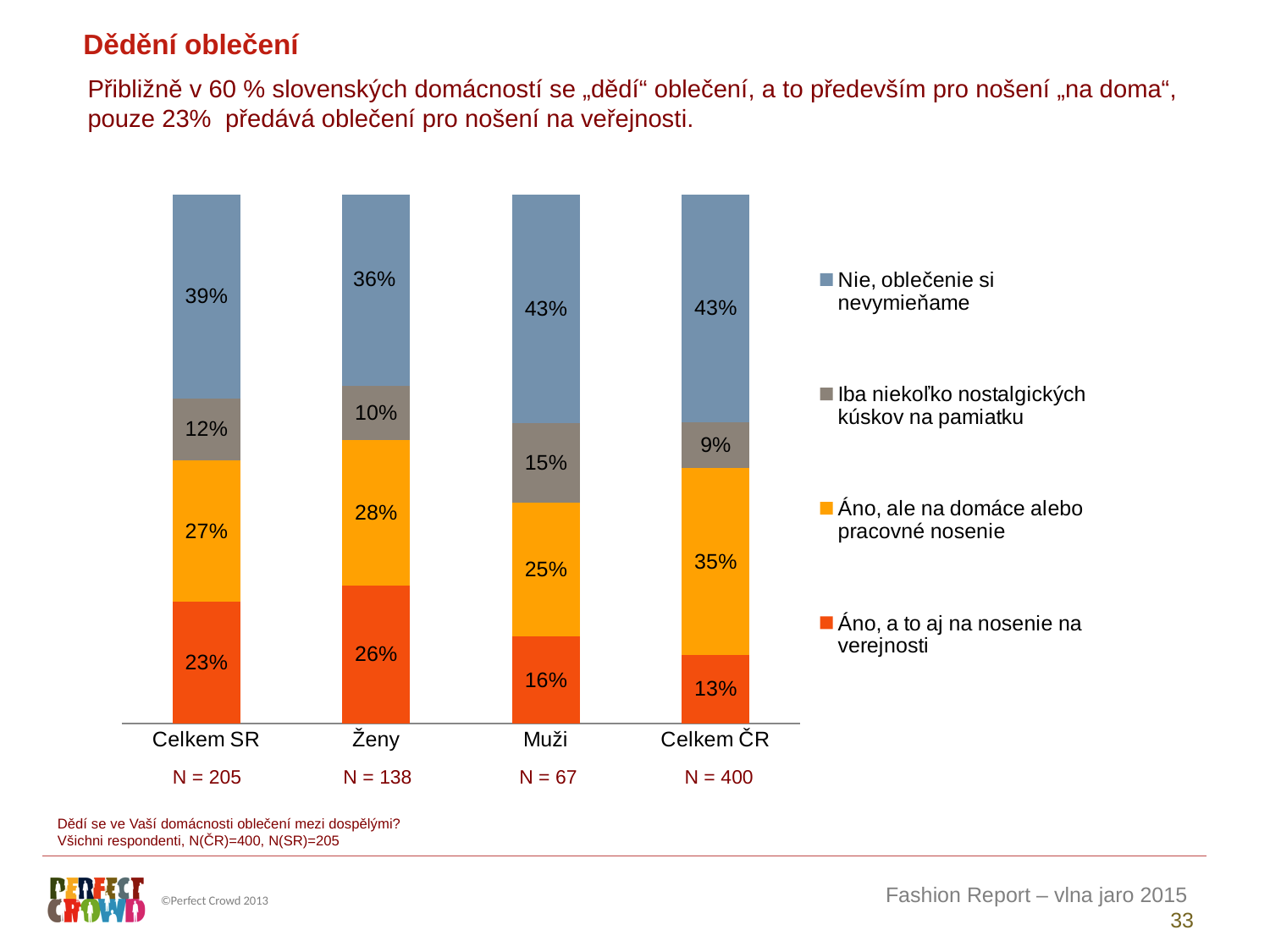
Which category has the lowest value for "Iba niekoľko nostalgických kúskov na pamiatku"? Celkem ČR How many series does the legend list? 4 How many categories are shown on the x axis of the chart? 4 What is the value for "Iba niekoľko nostalgických kúskov na pamiatku" in the Ženy bar? 10% What kind of chart is shown on the slide? Stacked bar chart Which category has the highest value for "Áno, a to aj na nosenie na verejnosti"? Ženy Which is larger for "Áno, ale na domáce alebo pracovné nosenie": Ženy or Muži? Ženy What is the difference between Celkem SR and Celkem ČR for "Áno, a to aj na nosenie na verejnosti"? 10 percentage points What is the value for "Áno, a to aj na nosenie na verejnosti" in the Celkem SR bar? 23% What is the value for "Áno, ale na domáce alebo pracovné nosenie" in the Celkem ČR bar? 35% What is the value for "Nie, oblečenie si nevymieňame" in the Muži bar? 43% What sample size (N) is shown under the Muži bar? N = 67